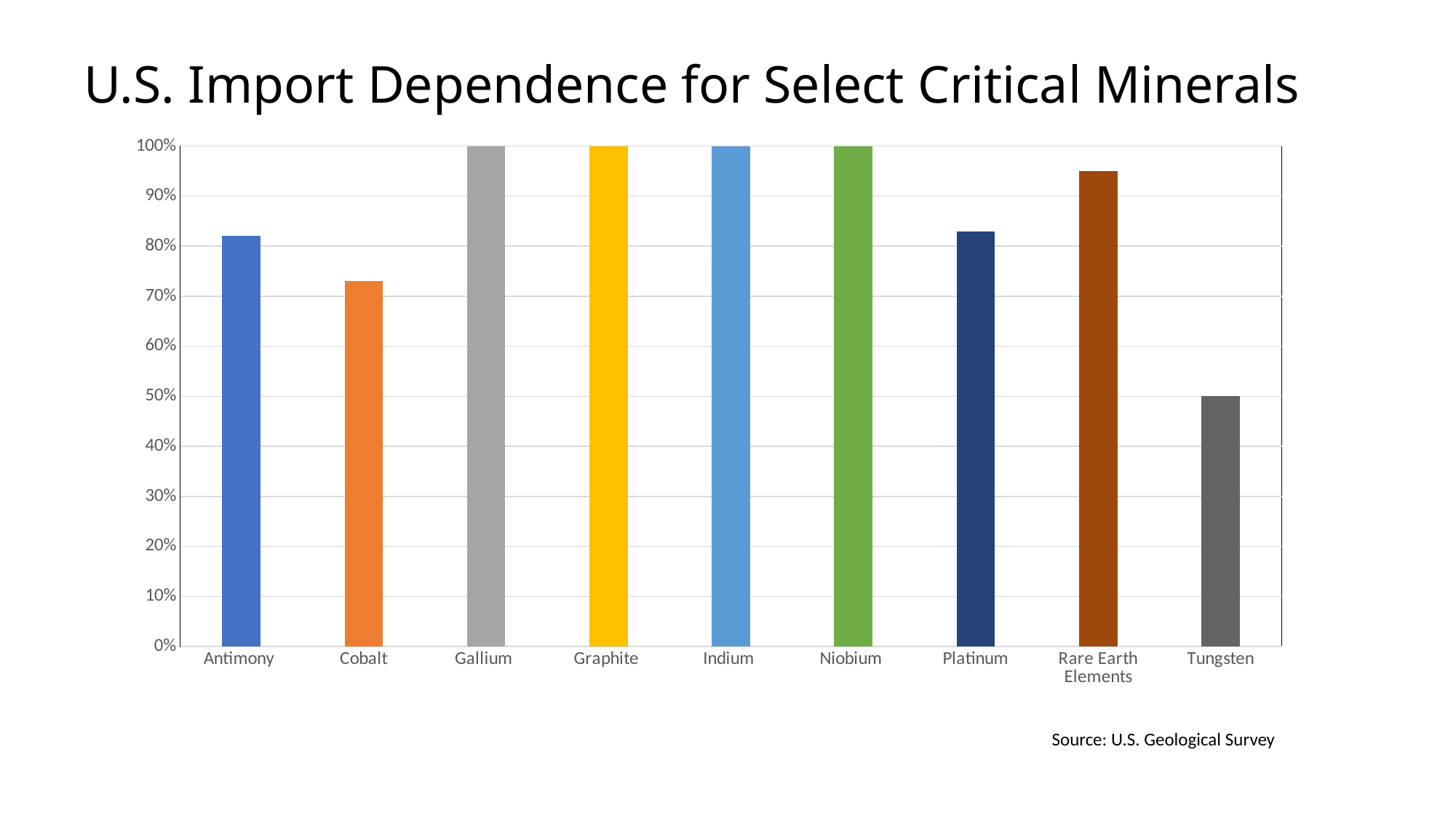
What is the title of the chart? U.S. Import Dependence for Select Critical Minerals Is the value for Cobalt greater or less than 70%? greater How many minerals are shown on the x axis of the chart? 9 What is the difference between the values for Graphite and Tungsten? 50% What is the import dependence value for Tungsten? 50% Which mineral has the lowest import dependence? Tungsten What type of chart is shown on the slide? bar chart How many minerals have an import dependence of 100%? 4 Is the value for Rare Earth Elements greater or less than 90%? greater What is the import dependence value for Gallium? 100% Which has a higher import dependence, Antimony or Cobalt? Antimony What is the import dependence value for Indium? 100%